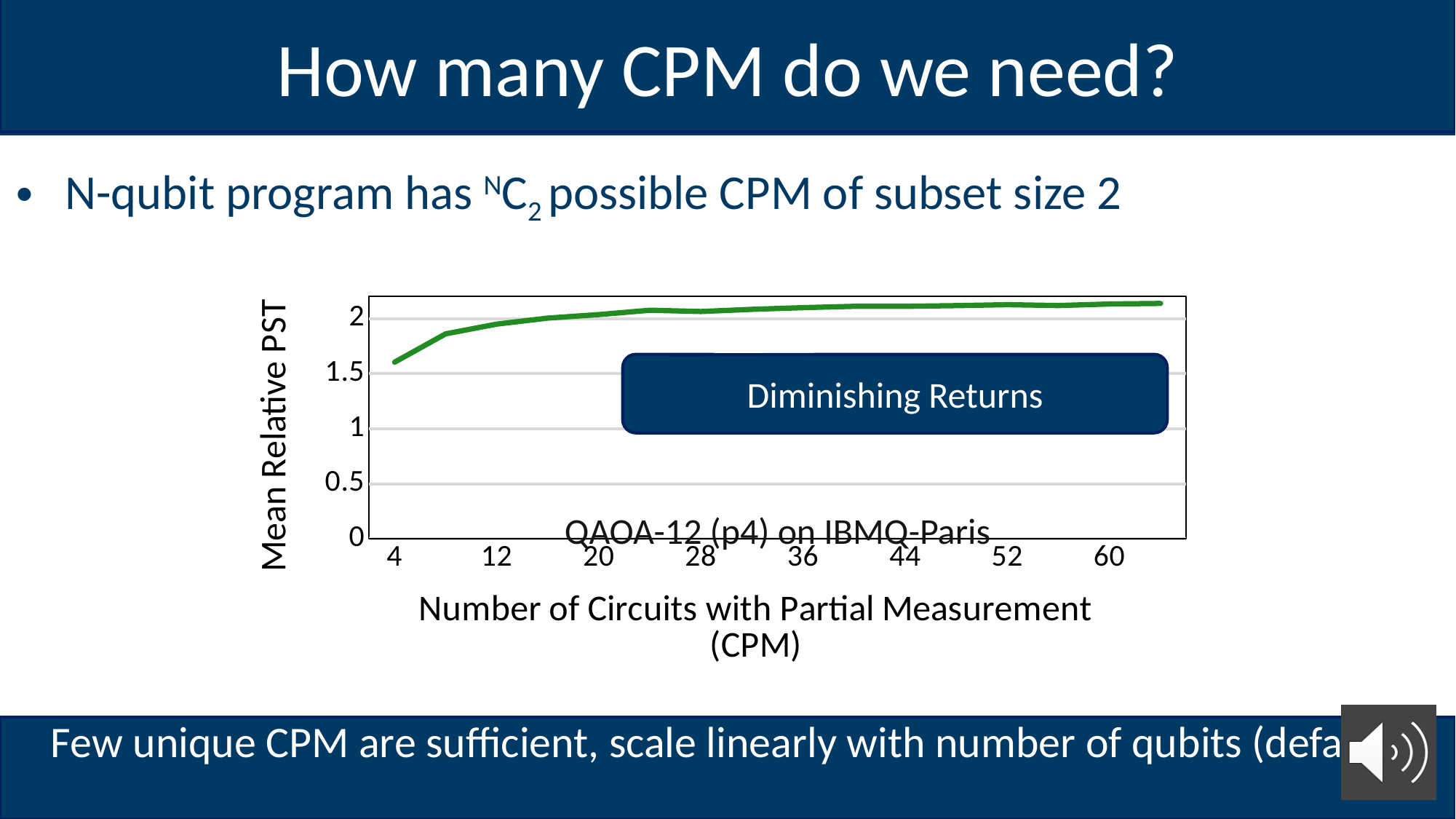
At which number of CPM on the x axis is the Mean Relative PST lowest? 4 What is the highest tick value shown on the y axis? 2 What is the title of the chart? QAOA-12 (p4) on IBMQ-Paris What kind of chart is shown on the slide? line chart What text appears in the annotation box overlaid on the chart? Diminishing Returns Is the Mean Relative PST at 36 CPM greater or less than 1.5? greater Is the Mean Relative PST at 12 CPM greater or less than 1.5? greater Does Mean Relative PST rise or fall as the number of CPM increases along the x axis? rise Which is larger, the Mean Relative PST at 4 CPM or at 28 CPM? 28 CPM Is the Mean Relative PST at 4 CPM greater or less than 1? greater What is the label of the y axis? Mean Relative PST